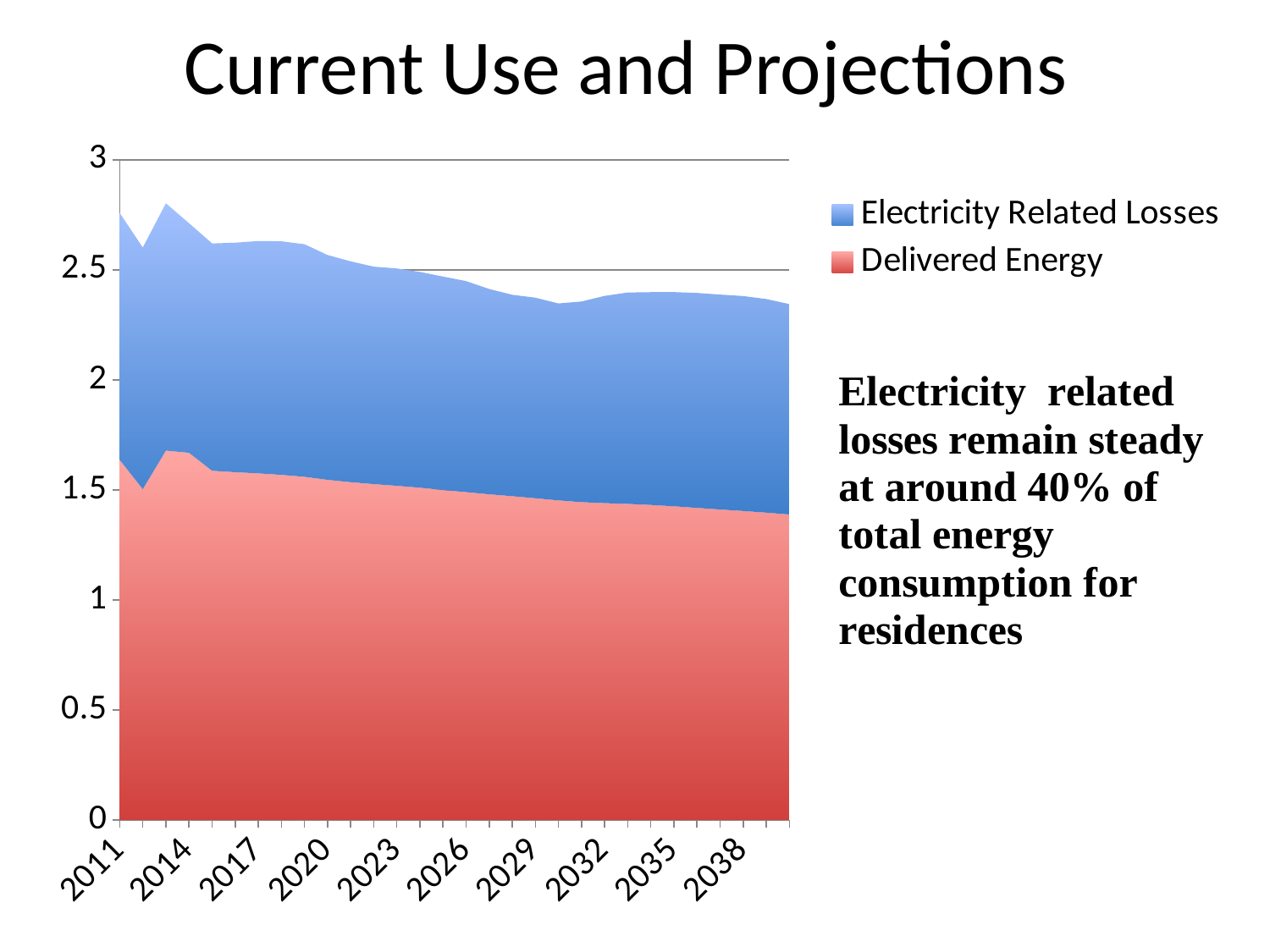
How many year labels are shown on the x axis? 10 How many series does the legend list? 2 Does Delivered Energy generally rise or fall from 2011 to 2038? Fall Is the stacked total of both series in 2038 greater or less than 2.5? less Is the value for Delivered Energy in 2011 greater or less than 1.5? greater Which series is larger in 2011, Delivered Energy or Electricity Related Losses? Delivered Energy Which colour represents Delivered Energy in the chart? Red Is the stacked total of both series in 2011 greater or less than 2.5? greater Does the stacked total of both series generally rise or fall from 2011 to 2038? Fall What are the two series named in the legend? Electricity Related Losses and Delivered Energy What kind of chart is shown on the slide? Stacked area chart